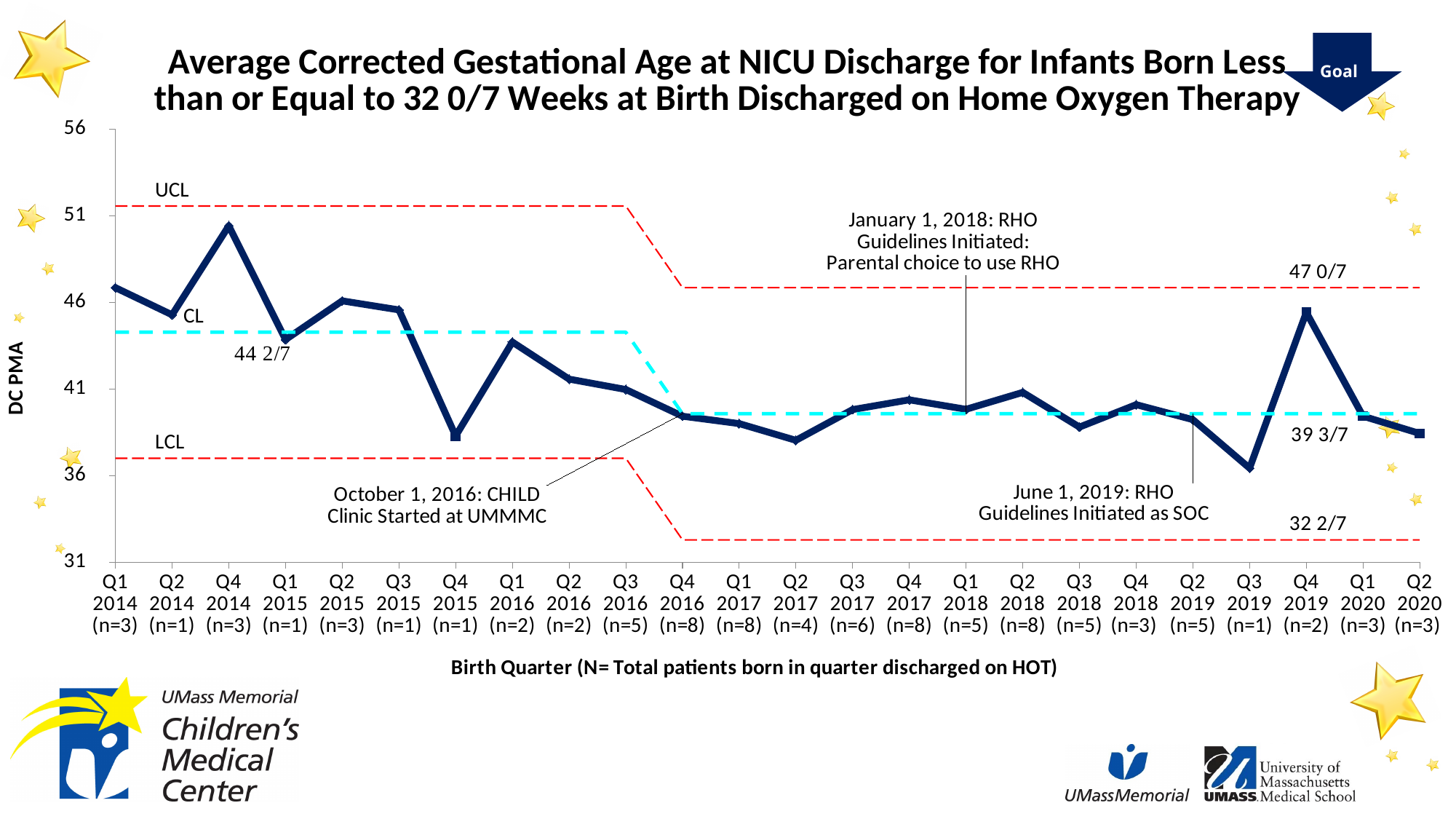
Which birth quarter has the highest average corrected gestational age at discharge? Q4 2014 Is the value for Q3 2019 greater or less than 41? less What kind of chart is shown on the slide? line chart Is the value for Q4 2014 greater or less than 46? greater What is the centre line (CL) value labelled for the later period of the chart? 39 3/7 Which birth quarter has the lowest average corrected gestational age at discharge? Q3 2019 What is the upper control limit (UCL) value labelled for the later period of the chart? 47 0/7 What is the centre line (CL) value labelled for the earlier period of the chart? 44 2/7 How many birth quarters are plotted along the x axis? 24 Which is larger, the value for Q4 2019 or the value for Q2 2020? Q4 2019 What is the label on the y axis? DC PMA What is the lower control limit (LCL) value labelled for the later period of the chart? 32 2/7